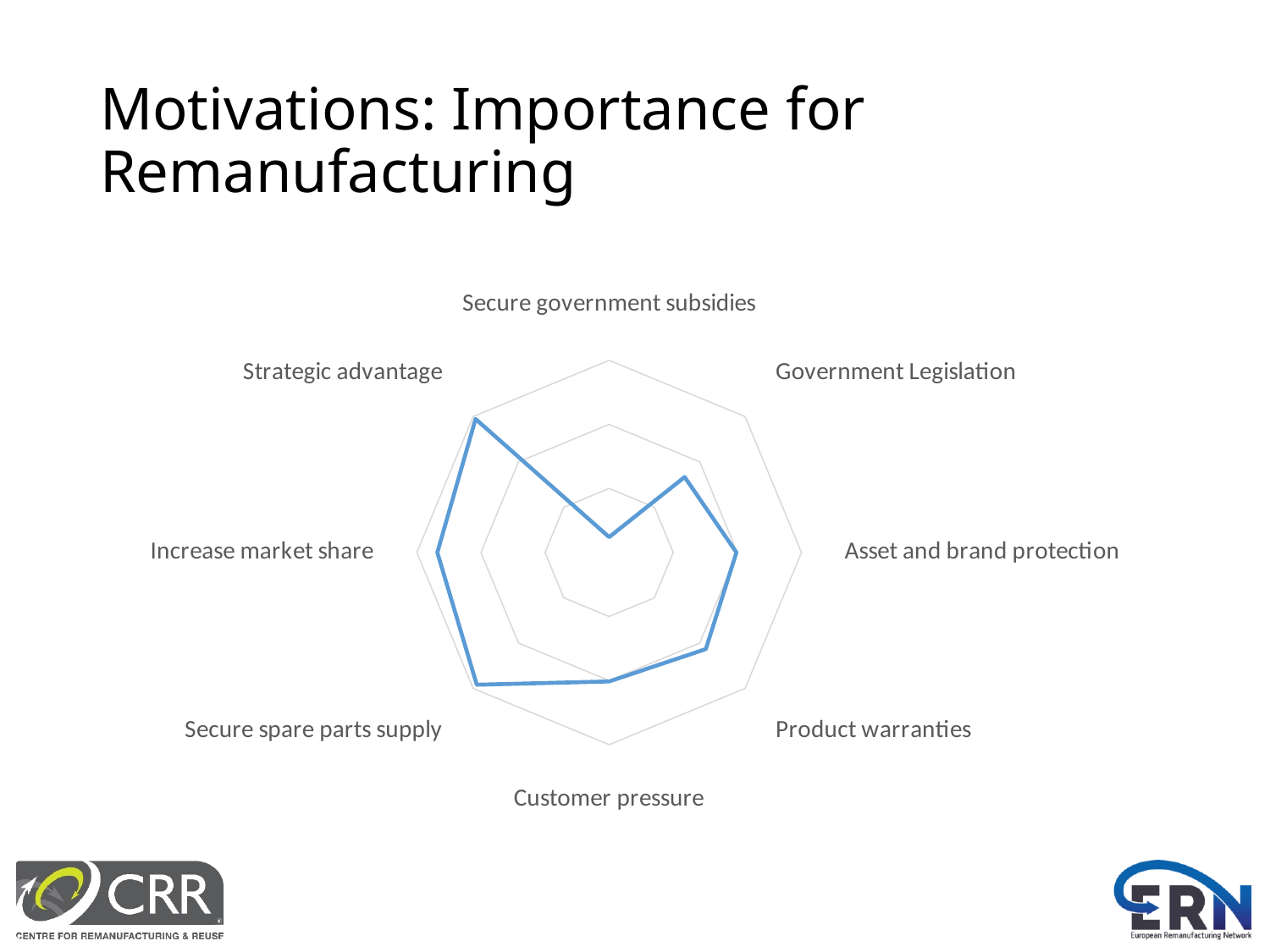
Which is larger, the value for Secure spare parts supply or the value for Secure government subsidies? Secure spare parts supply What is the title of the slide containing the radar chart? Motivations: Importance for Remanufacturing Which category has the lowest value on the radar chart? Secure government subsidies Which category is plotted at the top of the radar chart? Secure government subsidies Which is larger, the value for Strategic advantage or the value for Government Legislation? Strategic advantage How many motivation categories are plotted on the radar chart? 8 Which is larger, the value for Government Legislation or the value for Secure government subsidies? Government Legislation What kind of chart is shown on the slide? Radar chart